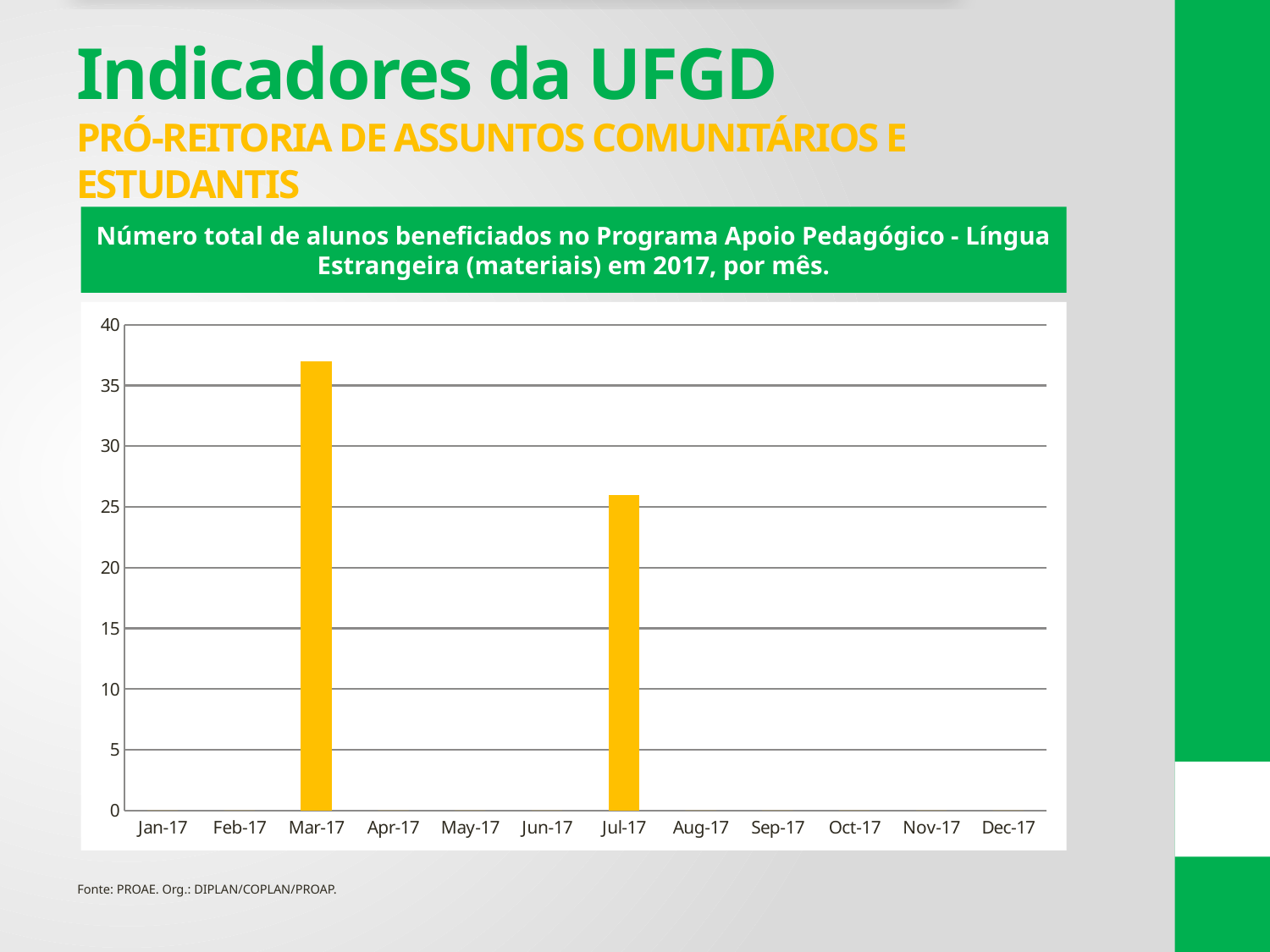
What colour are the bars in the chart? yellow What kind of chart is shown on the slide? bar chart How many months are shown on the x axis of the chart? 12 Is the value for Jul-17 greater or less than 20? greater What is the highest value shown on the y axis of the chart? 40 Which month has the highest number of students benefited? Mar-17 Is the value for Mar-17 greater or less than 40? less Which is larger, the value for Mar-17 or the value for Jul-17? Mar-17 Is the value for Mar-17 greater or less than 35? greater How many months show a bar with a value above zero? 2